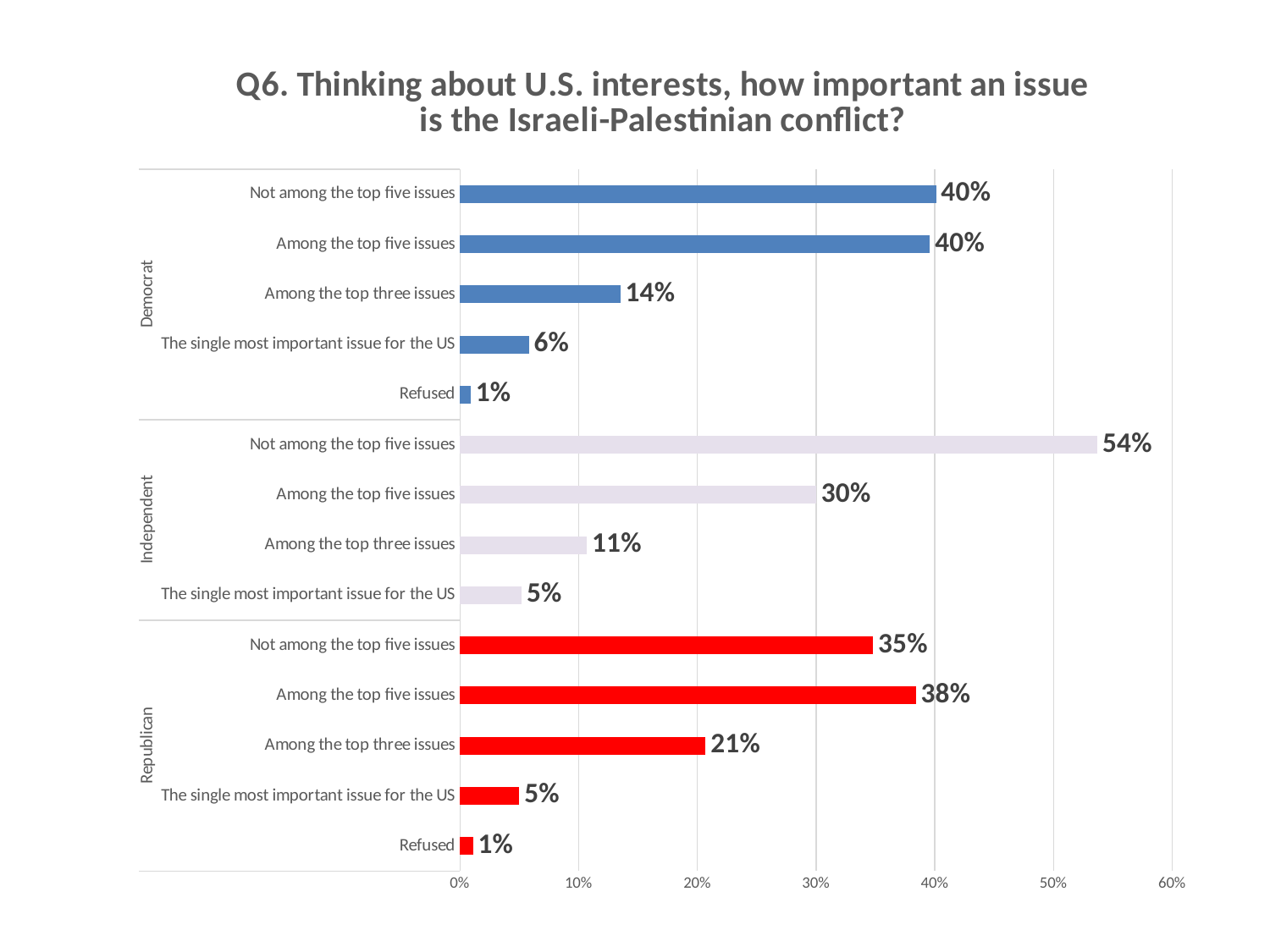
How many bars are plotted for the Independent group? 4 What percentage of Republicans said the conflict is among the top five issues? 38% What colour are the bars for the Republican group? Red What percentage of Democrats said the Israeli-Palestinian conflict is among the top three issues? 14% Is the Independent value for 'Among the top five issues' greater or less than 40%? less Which is larger: the Republican percentage for 'Among the top three issues' or the Democrat percentage for 'Among the top three issues'? Republican What percentage of Republicans said the conflict is the single most important issue for the US? 5% Which response has the highest percentage among Independents? Not among the top five issues What is the difference between the Independent and Republican percentages for 'Not among the top five issues'? 19% What percentage of Independents said the conflict is not among the top five issues? 54% Which response has the lowest percentage among Democrats? Refused What kind of chart is shown on the slide? Bar chart